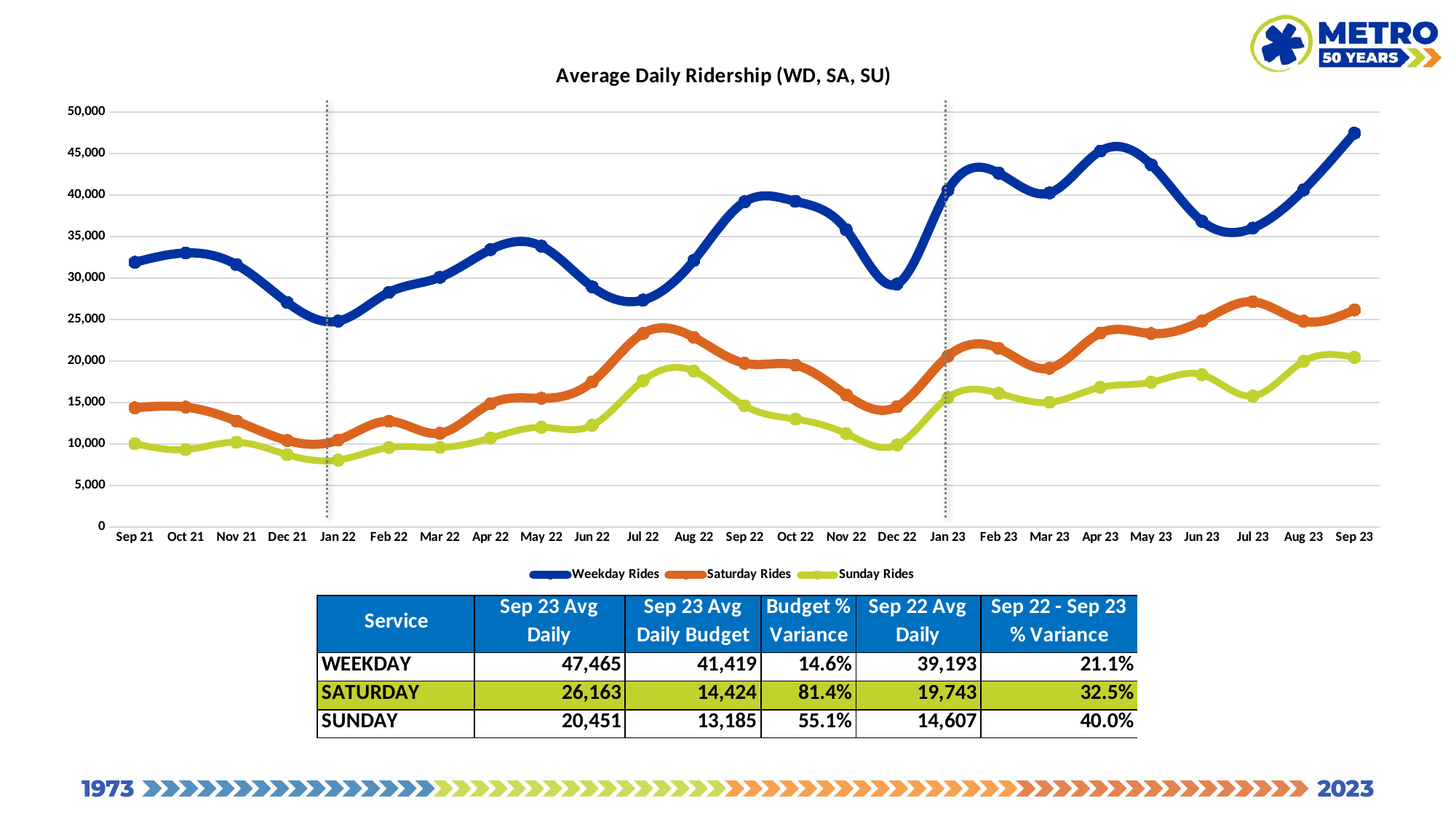
What is the difference between Weekday Rides in Sep 23 and Sep 22? 8,272 What is the value of Weekday Rides in Sep 23? 47,465 Is the value for Sunday Rides in Jul 22 greater or less than 15,000? greater Do Weekday Rides rise or fall from Jun 23 to Sep 23? rise In which month do Weekday Rides reach their lowest value? Jan 22 How many months are plotted along the x axis? 25 What is the value of Saturday Rides in Sep 22? 19,743 Is the value for Weekday Rides in Jan 22 greater or less than 30,000? less What kind of chart is shown on the slide? line chart How many series does the legend list? 3 Which series has the highest value in Sep 23? Weekday Rides In Dec 22, which is larger: Saturday Rides or Sunday Rides? Saturday Rides